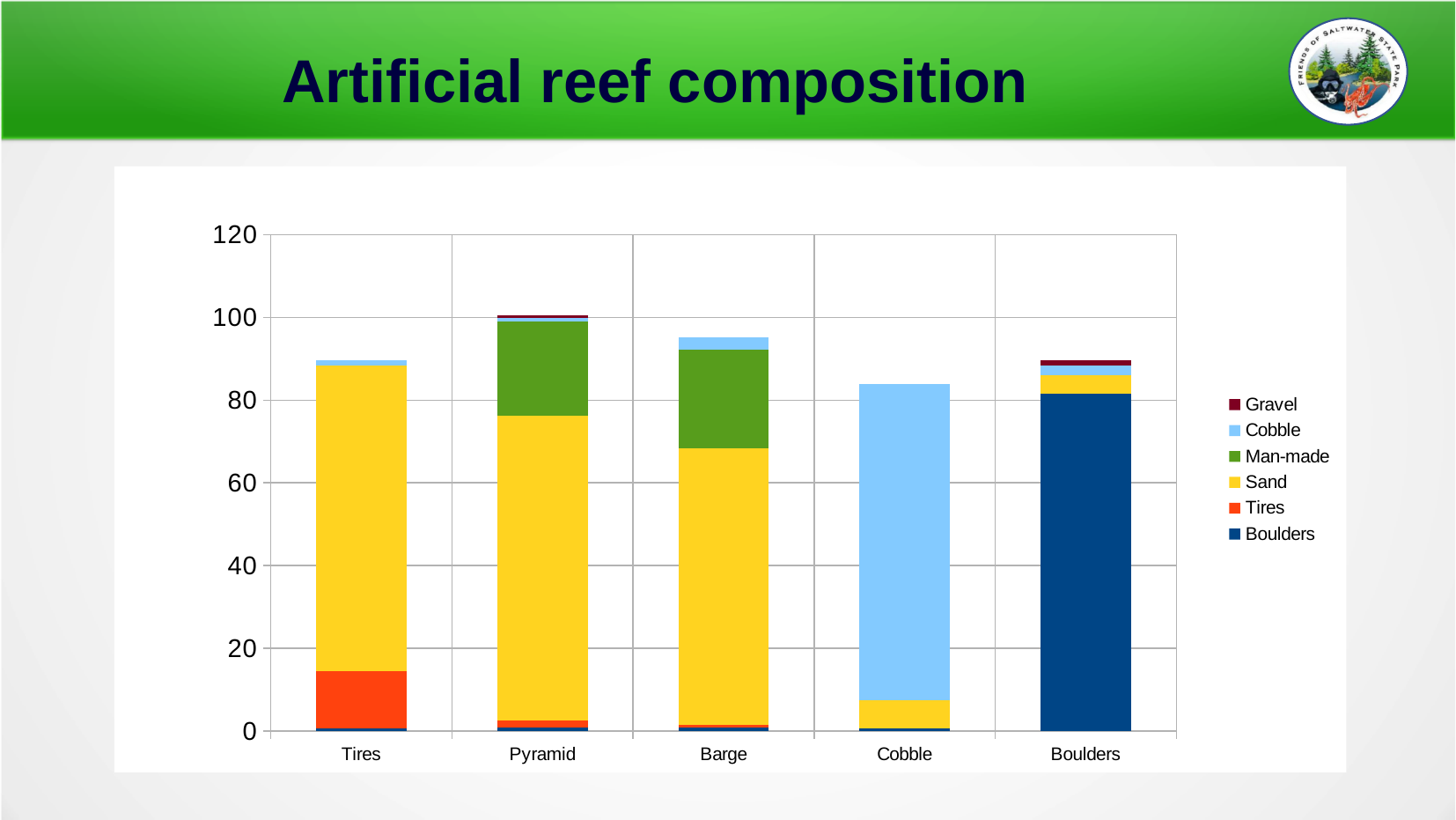
Is the total height of the Boulders bar greater or less than 60? greater Is the total height of the Barge bar greater or less than 100? less How many categories are shown on the x axis of the chart? 5 Which category has the tallest stacked bar overall? Pyramid Which legend series is shown in dark blue? Boulders Is the total height of the Tires bar greater or less than 80? greater Which category has the shortest stacked bar overall? Cobble What is the title of the slide containing the chart? Artificial reef composition Which stacked bar is taller overall, Pyramid or Cobble? Pyramid How many series does the legend list? 6 What kind of chart is shown on the slide? stacked bar chart